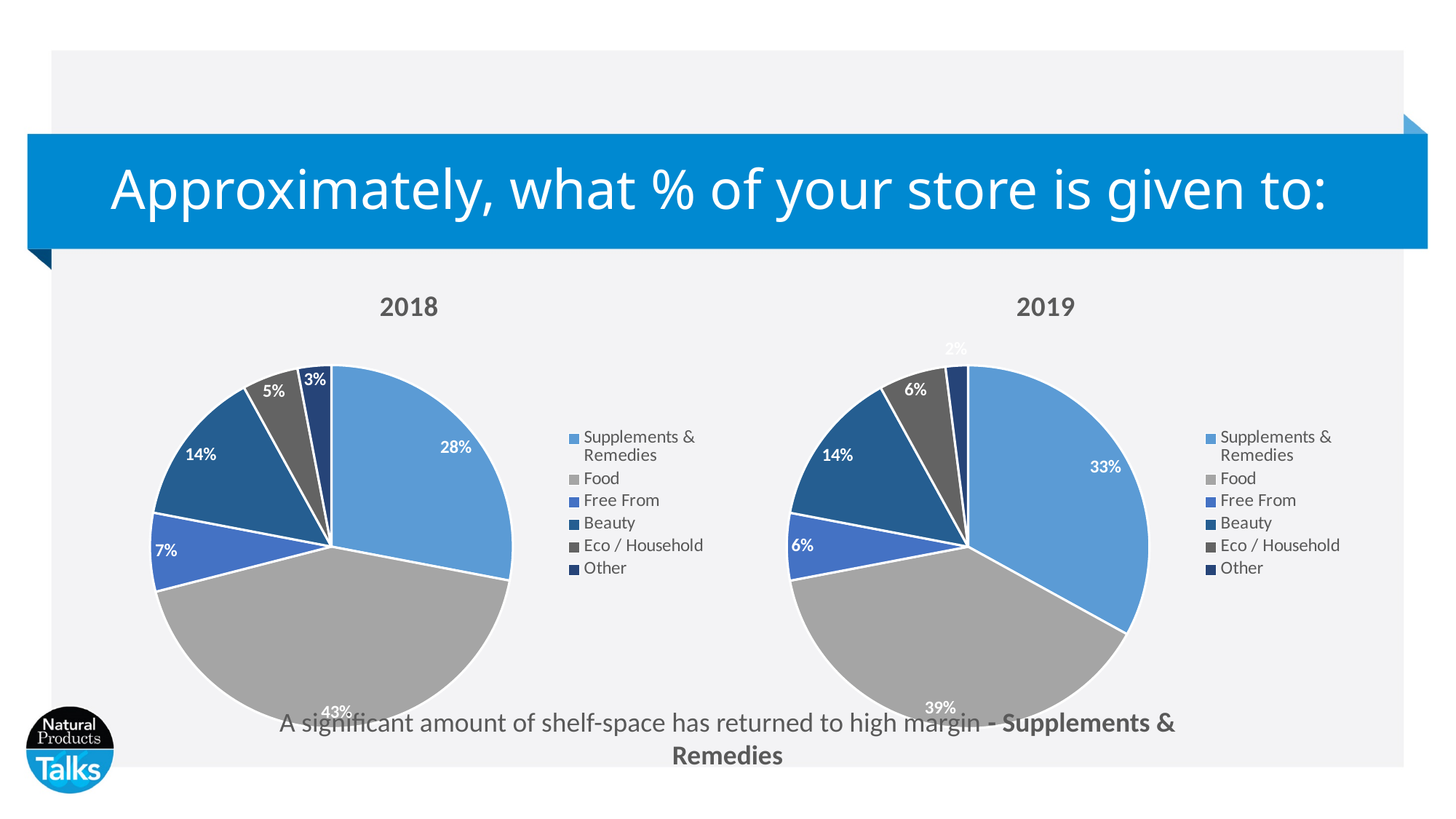
In the 2019 chart, which category has the smallest slice? Other What is the difference between the Food share in 2018 and the Food share in 2019? 4% What type of chart is used for the 2018 data? Pie chart In the 2019 chart, what share is given to Free From? 6% How many categories does the legend of the 2019 chart list? 6 In the 2019 chart, what share of the store is given to Food? 39% In the 2018 chart, what share is given to Beauty? 14% Is the Supplements & Remedies share larger in the 2018 chart or the 2019 chart? 2019 In the 2019 chart, what share is given to Eco / Household? 6% In the 2018 chart, which category has the smallest slice? Other In the 2018 chart, what share of the store is given to Supplements & Remedies? 28% In the 2018 chart, which category has the largest slice? Food